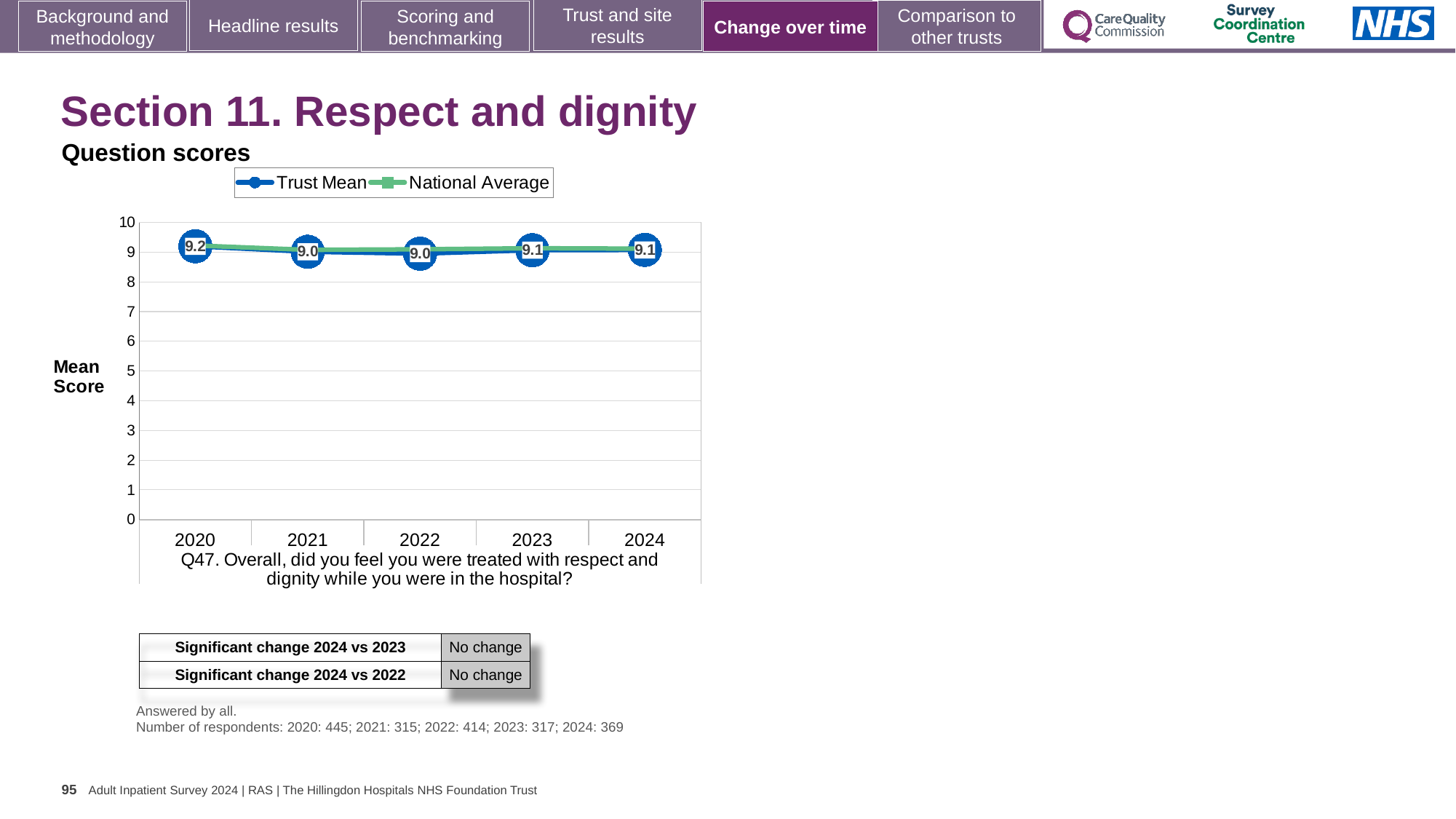
What is the Trust Mean score for 2024? 9.1 Does the Trust Mean score rise or fall from 2022 to 2024? rise What is the Trust Mean score for 2020? 9.2 How many years are plotted on the x axis? 5 What is the difference between the Trust Mean scores for 2020 and 2021? 0.2 How many series does the legend list? 2 Is the National Average value for 2024 greater or less than 8? greater In which year is the Trust Mean score highest? 2020 Which year has the larger Trust Mean score, 2020 or 2022? 2020 What kind of chart is shown? line chart What is the Trust Mean score for 2022? 9.0 What is the label of the y axis? Mean Score